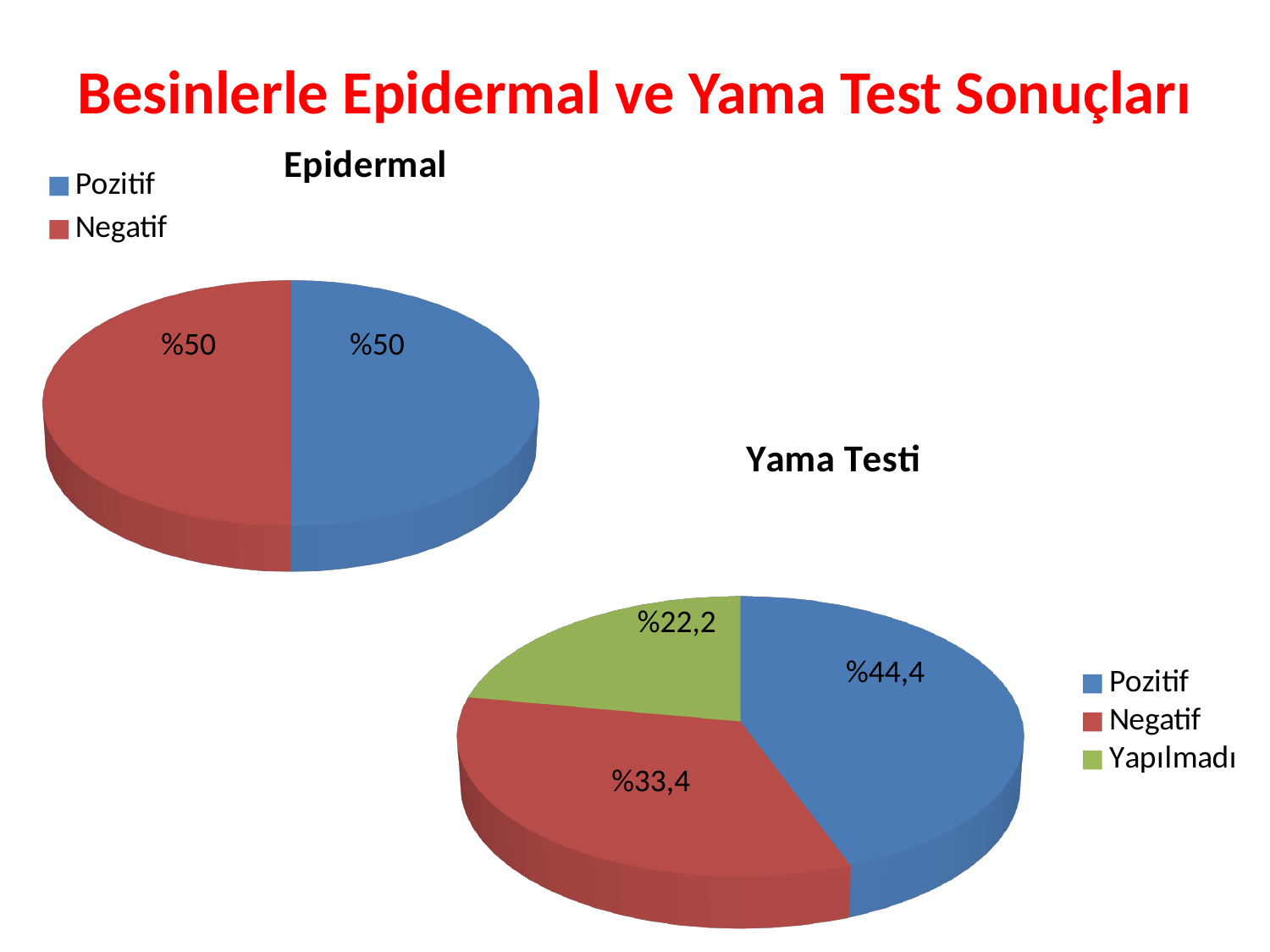
In the Epidermal chart, what is the value for Pozitif? %50 What kind of chart is the Epidermal chart? Pie chart In the Yama Testi chart, what is the value for Negatif? %33,4 In the Yama Testi chart, what is the value for Yapılmadı? %22,2 How many slices does the Yama Testi chart have? 3 In the Yama Testi chart, which category has the largest slice? Pozitif How many entries does the legend of the Epidermal chart list? 2 In the Yama Testi chart, what is the difference between the Pozitif and Negatif values? %11 In the Yama Testi chart, which category has the smallest slice? Yapılmadı In the Yama Testi chart, what is the value for Pozitif? %44,4 In the Yama Testi chart, which is larger, Negatif or Yapılmadı? Negatif In the Epidermal chart, what is the value for Negatif? %50